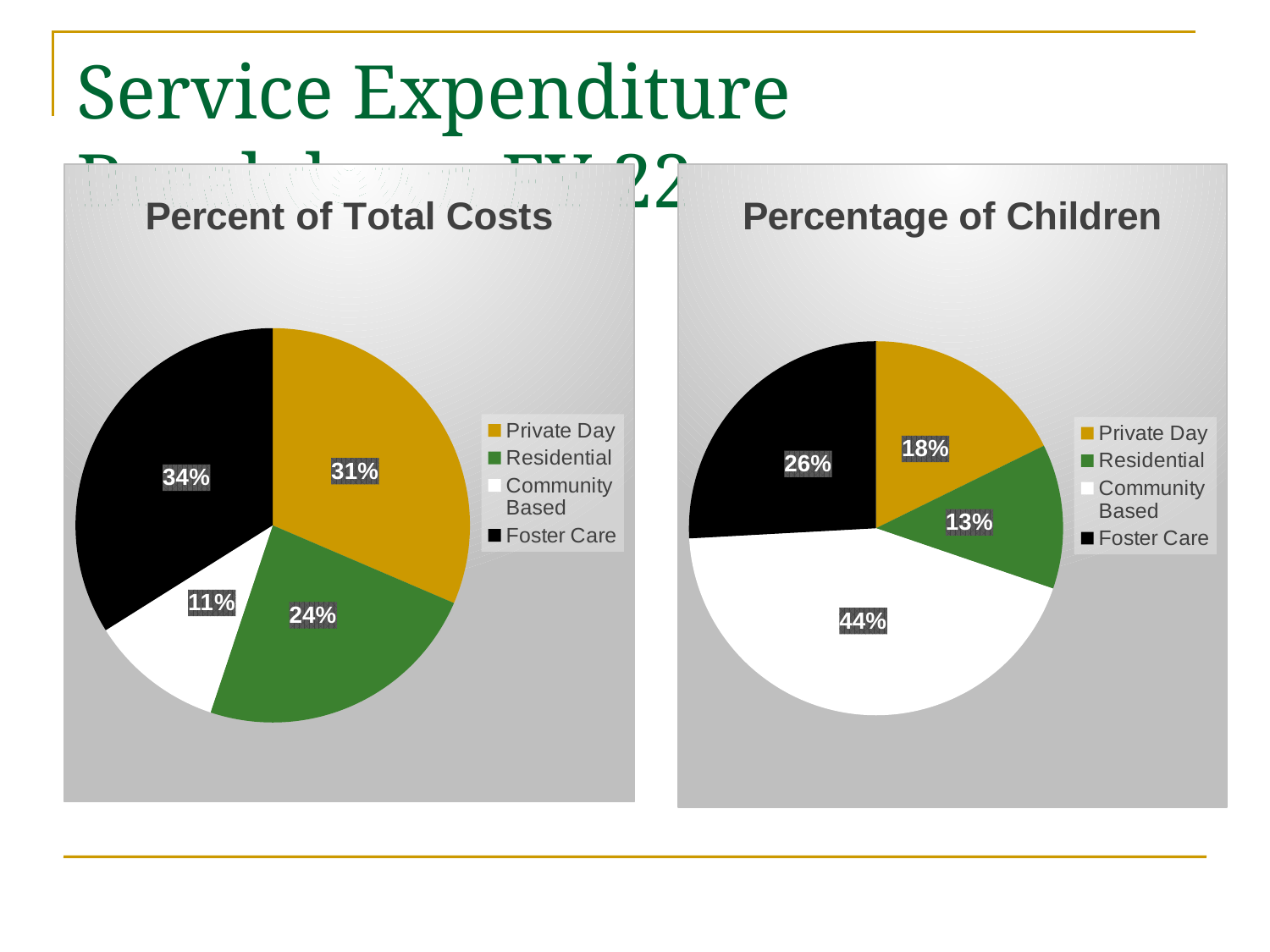
In the 'Percentage of Children' chart, which is larger: Private Day or Foster Care? Foster Care In the 'Percentage of Children' chart, what percentage is shown for Community Based? 44% How many slices does the 'Percent of Total Costs' pie chart have? 4 In the 'Percent of Total Costs' chart, what percentage is shown for Residential? 24% In the 'Percent of Total Costs' chart, what is the difference between the Foster Care and Community Based percentages? 23% In the 'Percent of Total Costs' chart, which category has the largest slice? Foster Care In the 'Percentage of Children' chart, which category has the smallest slice? Residential What colour represents Foster Care in both pie charts? Black How many entries does the legend of the 'Percentage of Children' chart list? 4 In the 'Percentage of Children' chart, what is the difference between the Community Based and Residential percentages? 31% In the 'Percent of Total Costs' chart, what percentage is shown for Private Day? 31% What type of chart is the 'Percent of Total Costs' chart? Pie chart